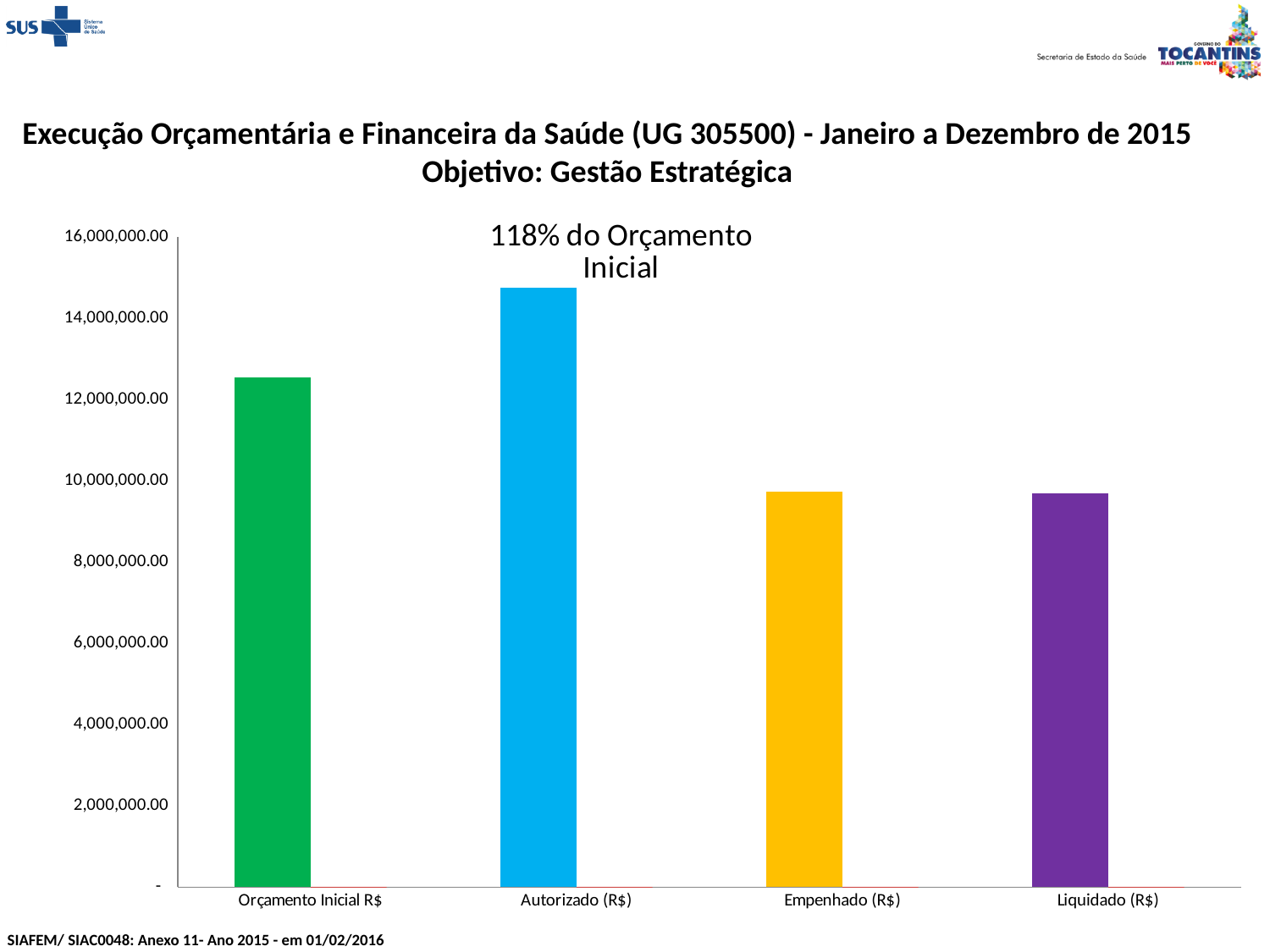
Is the value for Empenhado (R$) greater or less than 10,000,000.00? less What kind of chart is shown on the slide? bar chart Is the value for Autorizado (R$) greater or less than 16,000,000.00? less Which category has the highest bar in the chart? Autorizado (R$) What colour is the bar for Autorizado (R$)? blue Which is larger, the value for Autorizado (R$) or the value for Orçamento Inicial R$? Autorizado (R$) How many categories are plotted on the x axis of the chart? 4 Is the value for Autorizado (R$) greater or less than 14,000,000.00? greater Which is larger, the value for Orçamento Inicial R$ or the value for Empenhado (R$)? Orçamento Inicial R$ What is the title printed above the bars of the chart? 118% do Orçamento Inicial